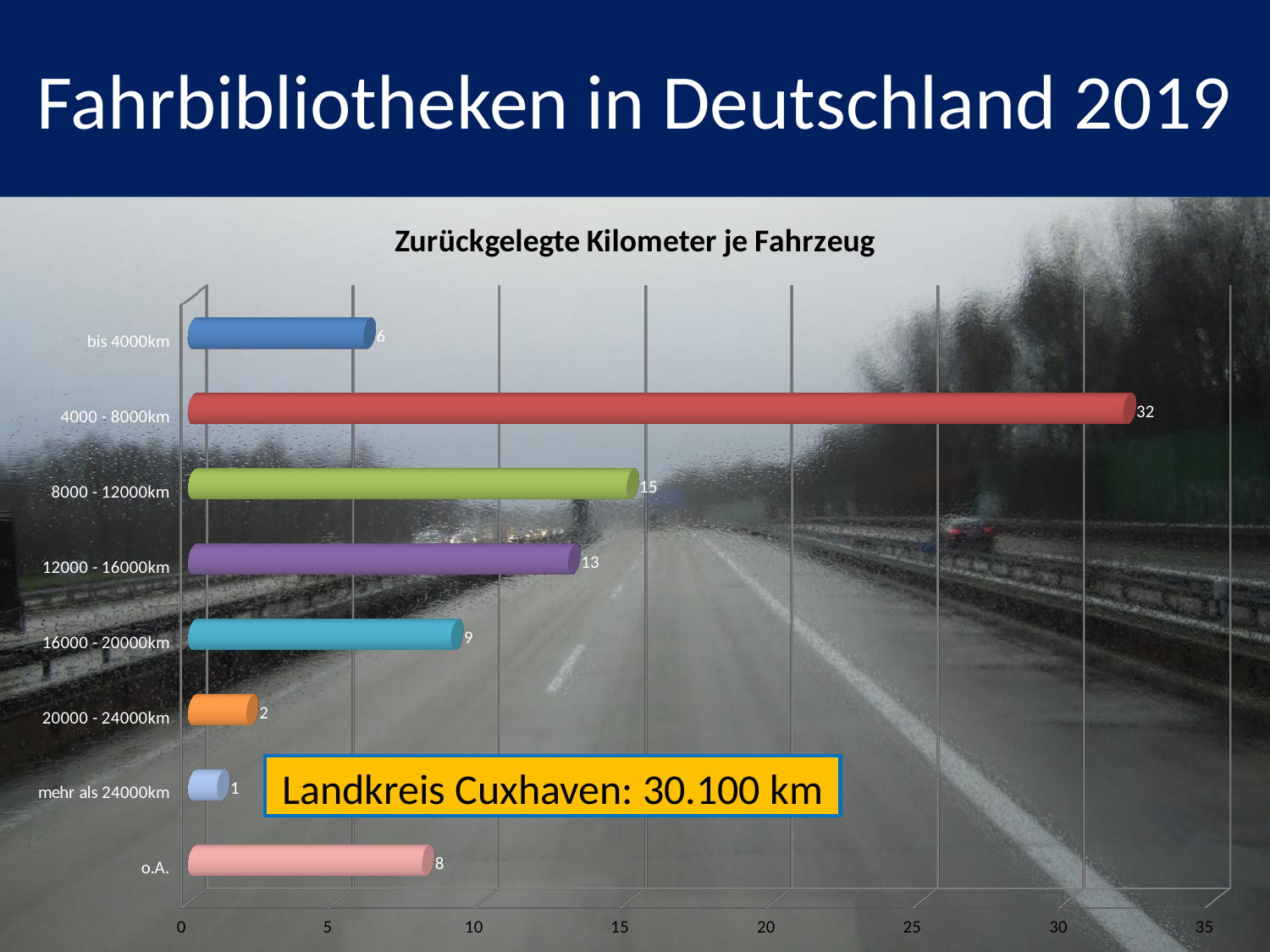
What is the title of the chart? Zurückgelegte Kilometer je Fahrzeug What is the value for the category '12000 - 16000km'? 13 Which category has the lowest value? mehr als 24000km What kind of chart is shown on the slide? bar chart How many categories are shown in the chart? 8 What is the value for the category 'o.A.'? 8 What is the value for the category 'bis 4000km'? 6 Is the value for '8000 - 12000km' greater or less than 10? greater Which category has the highest value? 4000 - 8000km What is the difference between the values for '4000 - 8000km' and '8000 - 12000km'? 17 What is the value for the category '4000 - 8000km'? 32 Which is larger, the value for '16000 - 20000km' or the value for 'o.A.'? 16000 - 20000km